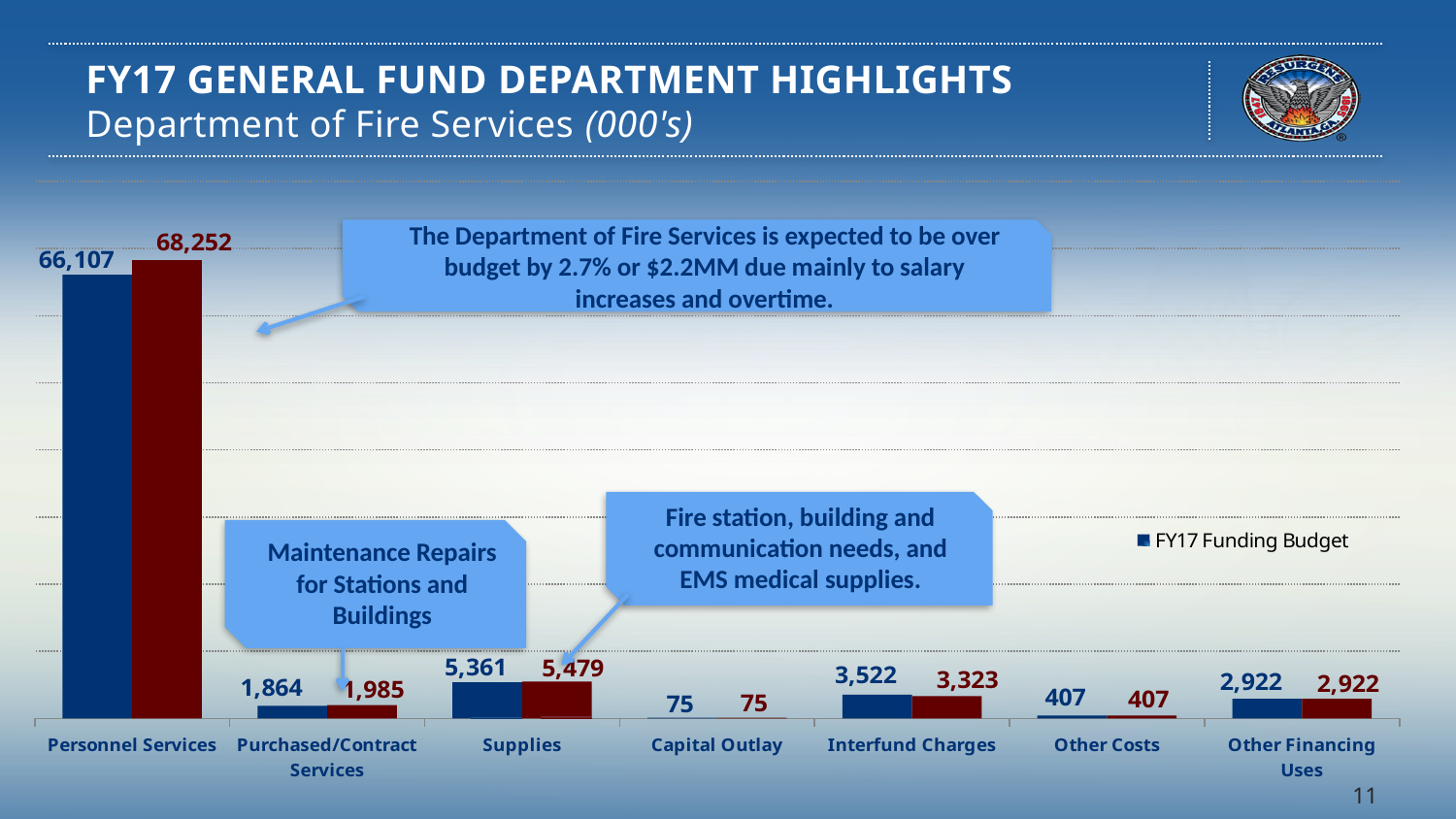
For Supplies, what is the difference between the dark red bar (5,479) and the FY17 Funding Budget bar (5,361)? 118 Which has the larger FY17 Funding Budget value, Supplies or Interfund Charges? Supplies Which category has the highest FY17 Funding Budget value? Personnel Services What kind of chart is shown on the slide? Bar chart What is the FY17 Funding Budget value for Personnel Services? 66,107 What is the FY17 Funding Budget value for Interfund Charges? 3,522 For Interfund Charges, what is the difference between the FY17 Funding Budget bar (3,522) and the dark red bar (3,323)? 199 How many categories are shown on the x axis of the chart? 7 For Personnel Services, what is the difference between the dark red bar (68,252) and the FY17 Funding Budget bar (66,107)? 2,145 What is the FY17 Funding Budget value for Supplies? 5,361 What is the FY17 Funding Budget value for Other Costs? 407 Which category has the lowest FY17 Funding Budget value? Capital Outlay